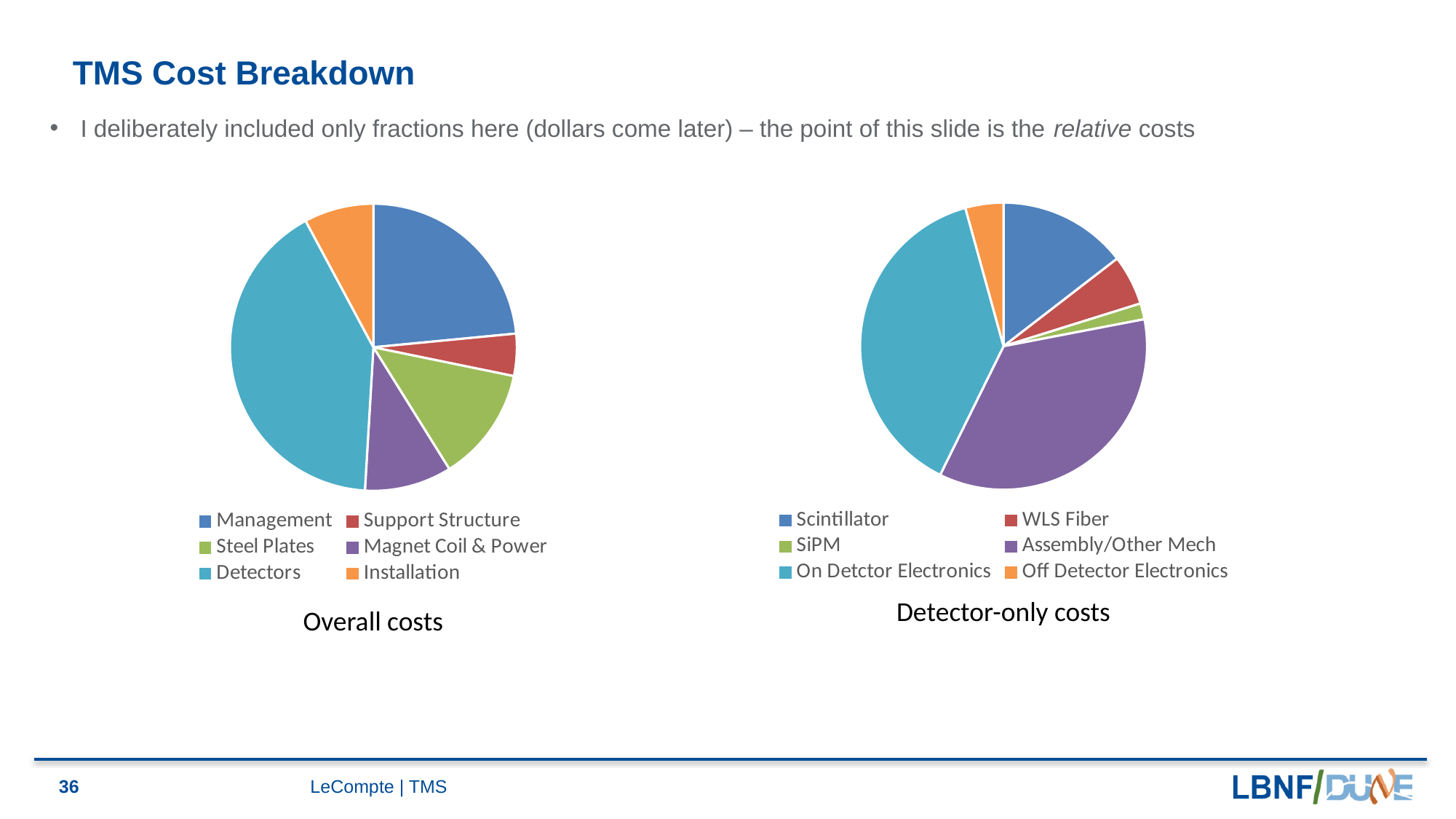
In the Overall costs chart, which slice is larger, Installation or Support Structure? Installation How many categories does the Detector-only costs pie chart have? 6 In the Overall costs chart, which slice is larger, Management or Steel Plates? Management What kind of chart is the Overall costs chart? pie chart In the Overall costs chart, which category has the smallest slice? Support Structure How many categories does the Overall costs pie chart have? 6 In the Overall costs chart, which category has the largest slice? Detectors In the Detector-only costs chart, which category has the largest slice? On Detctor Electronics What kind of chart is the Detector-only costs chart? pie chart In the Detector-only costs chart, which category has the smallest slice? SiPM In the Detector-only costs chart, which slice is larger, Scintillator or WLS Fiber? Scintillator In the Overall costs chart, what colour is the Detectors slice? teal